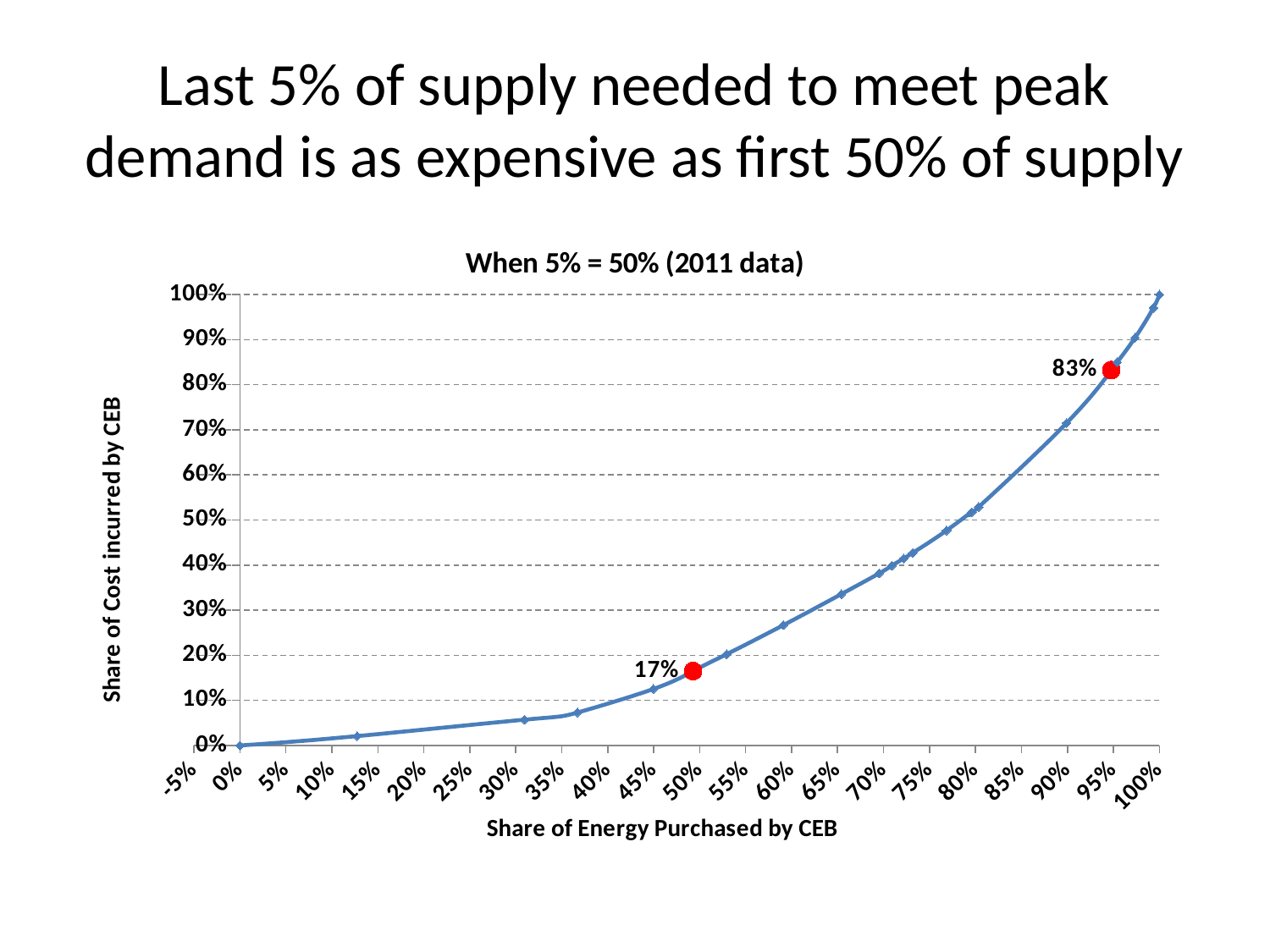
What is the difference between the labelled cost shares at 95% and 50% of energy purchased? 66% What is the label of the vertical axis? Share of Cost incurred by CEB Is the share of cost at 60% of energy purchased greater or less than 30%? less What is the share of cost incurred by CEB when the share of energy purchased is 95%? 83% What kind of chart is shown on the slide? line chart What is the title of the chart? When 5% = 50% (2011 data) Is the share of cost at 80% of energy purchased greater or less than 50%? greater Which is larger: the share of cost at 95% of energy purchased or at 50% of energy purchased? 95% of energy purchased Is the share of cost at 35% of energy purchased greater or less than 10%? less Does the share of cost rise or fall as the share of energy purchased increases? rises What is the share of cost incurred by CEB when the share of energy purchased is 50%? 17%